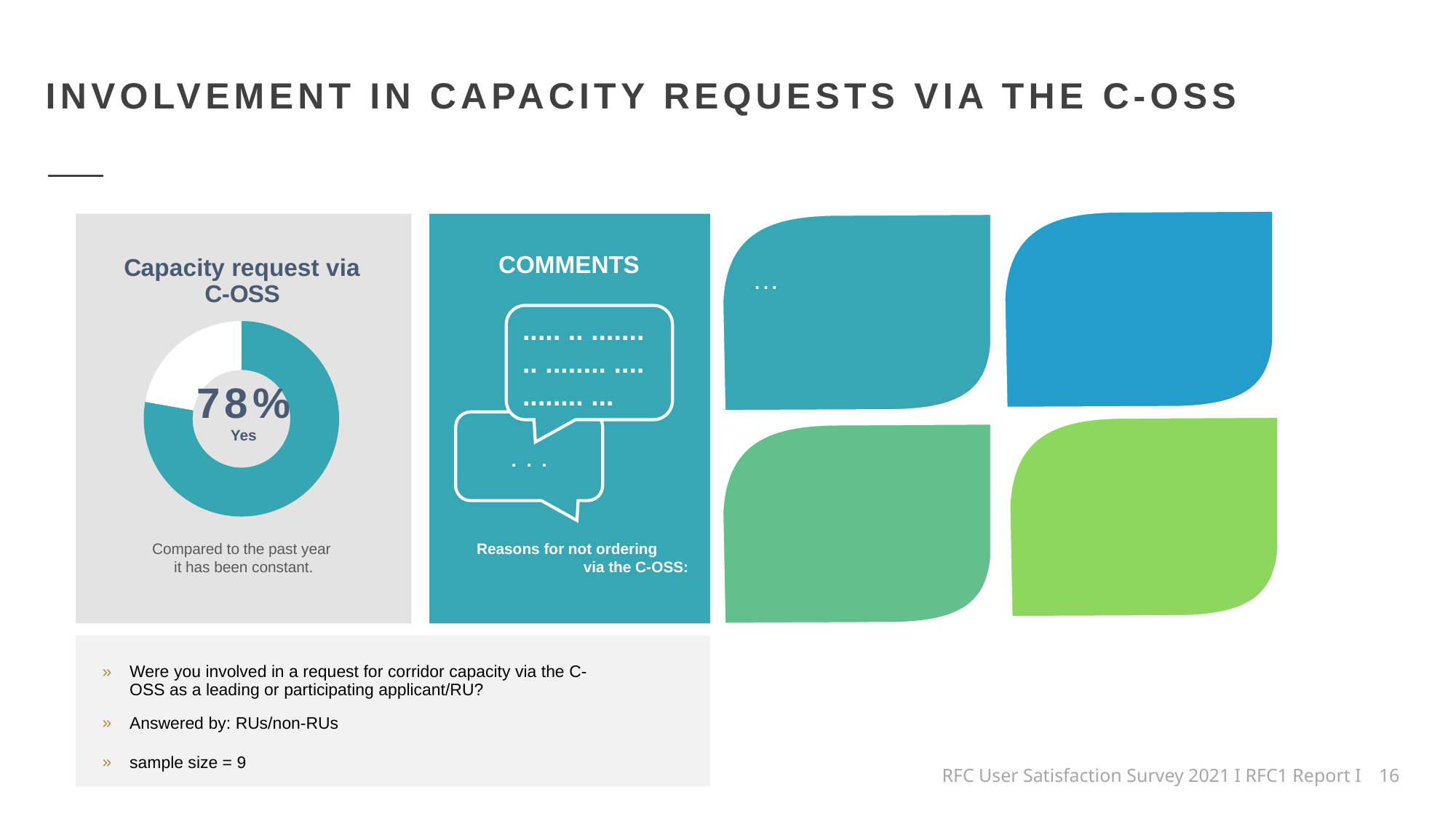
What percentage of respondents answered "Yes" in the "Capacity request via C-OSS" chart? 78% In the "Capacity request via C-OSS" chart, which is larger: the "Yes" segment or the remaining segment? Yes What share of the "Capacity request via C-OSS" donut does the "Yes" segment represent? 78% What is the title of the donut chart on the slide? Capacity request via C-OSS What kind of chart is shown under the heading "Capacity request via C-OSS"? donut (pie) chart In the "Capacity request via C-OSS" chart, is the "Yes" share greater or less than 50%? greater What colour is the "Yes" segment in the "Capacity request via C-OSS" donut chart? teal How many segments does the "Capacity request via C-OSS" donut chart have? 2